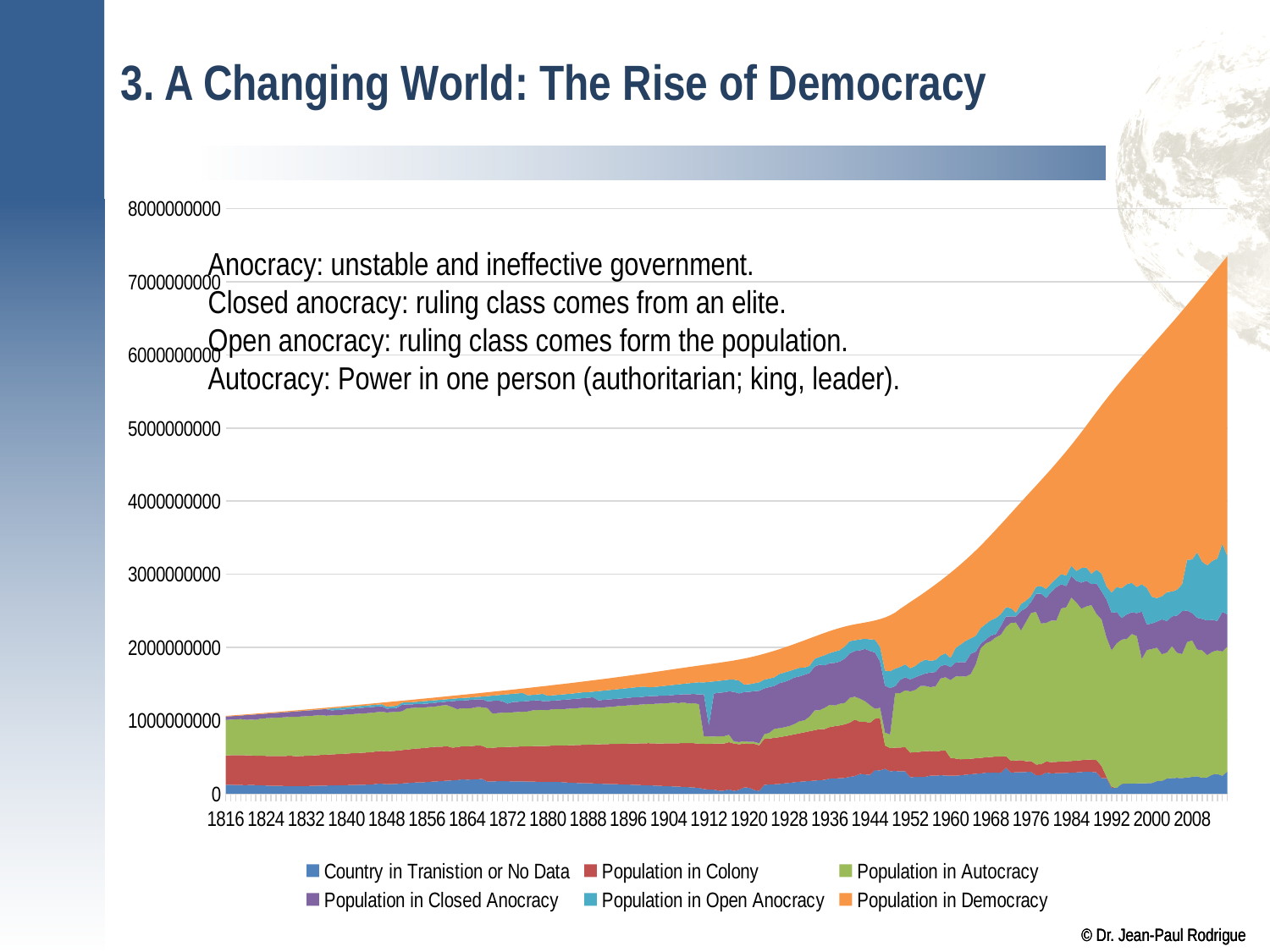
How many series does the legend list? 6 Does the total stacked population rise or fall from 1816 to the right end of the chart? Rise What kind of chart is shown on the slide? Stacked area chart What is the highest value shown on the y axis? 8000000000 What is the last year labelled on the x axis? 2008 Which series is plotted at the bottom of the stack (the blue area)? Country in Tranistion or No Data Does the Population in Colony band grow or shrink toward the right end of the chart? Shrink Which series is plotted at the top of the stack (the orange area)? Population in Democracy Is the total stacked population in 1816 greater or less than 2000000000? less How many year labels are shown on the x axis? 25 Is the total stacked population at the far right end of the chart greater or less than 6000000000? greater What is the first year shown on the x axis? 1816